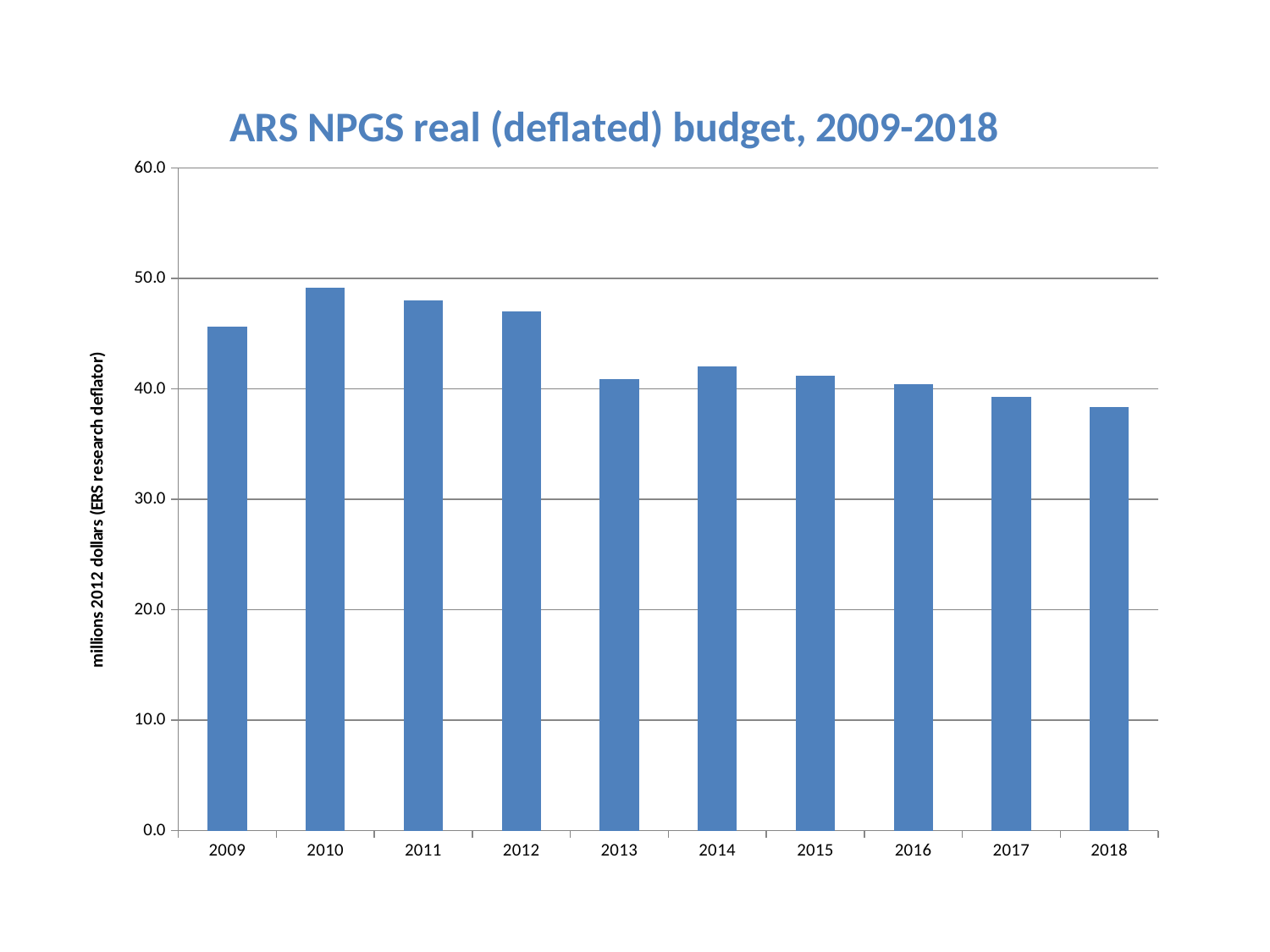
What kind of chart is shown on the slide? bar chart Is the value for 2010 greater or less than 50.0? less Which year has the highest real budget? 2010 Which year has the lowest real budget? 2018 Which year has the larger real budget, 2012 or 2014? 2012 What is the title of the chart? ARS NPGS real (deflated) budget, 2009-2018 What is the label on the vertical axis of the chart? millions 2012 dollars (ERS research deflator) Which year has the larger real budget, 2010 or 2013? 2010 How many years are plotted on the chart? 10 Overall, do the values rise or fall from 2009 to 2018? fall Is the value for 2009 greater or less than 40.0? greater Is the value for 2018 greater or less than 40.0? less